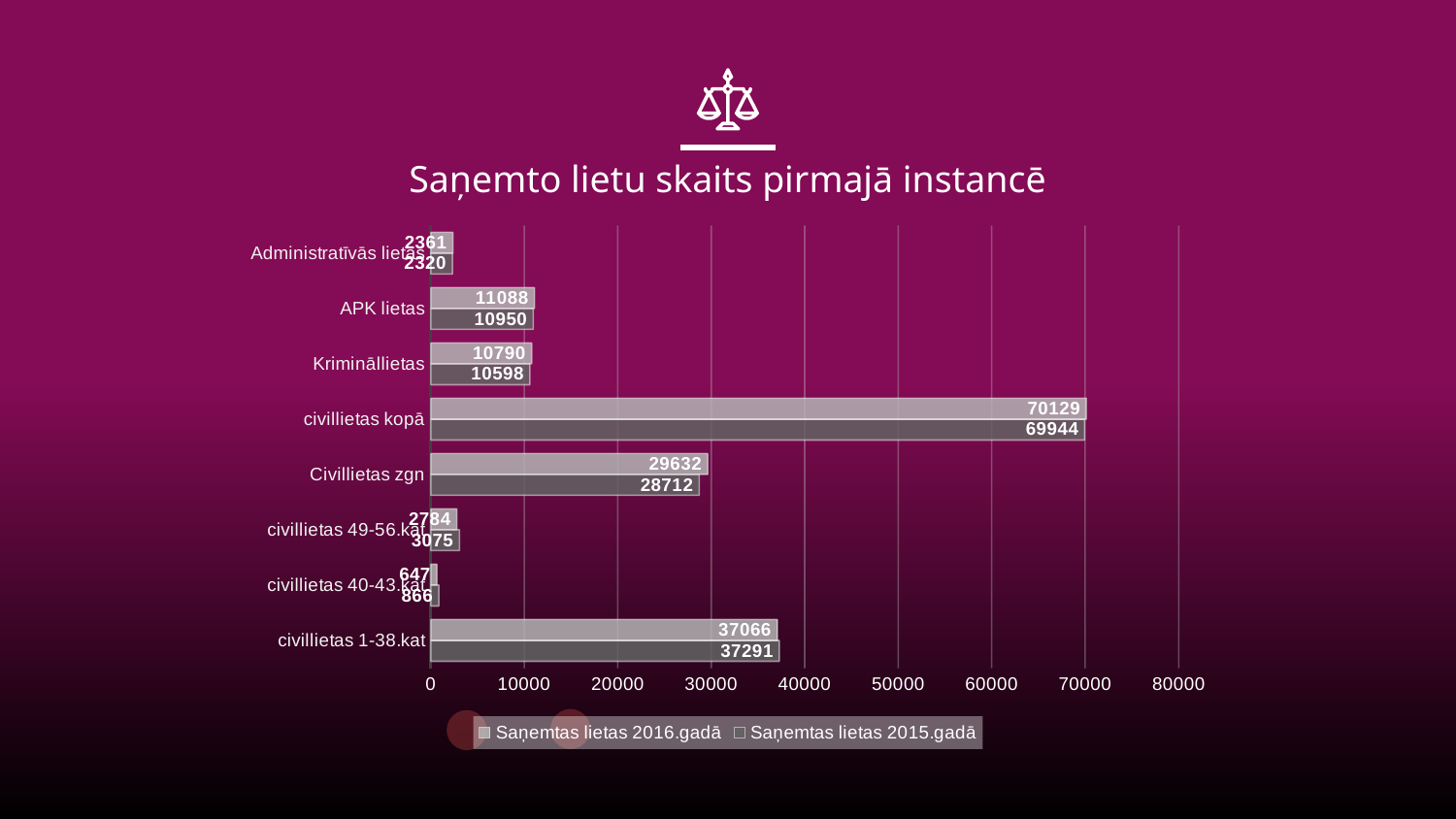
What is the value for civillietas kopā in the series Saņemtas lietas 2016.gadā? 69944 What is the title of the chart? Saņemto lietu skaits pirmajā instancē How many categories are shown on the chart? 8 What is the value for APK lietas in the series Saņemtas lietas 2015.gadā? 11088 What type of chart is shown on the slide? bar chart What is the difference between the 2015 and 2016 values for civillietas kopā? 185 For civillietas 1-38.kat, which series has the larger value, Saņemtas lietas 2016.gadā or Saņemtas lietas 2015.gadā? Saņemtas lietas 2016.gadā Which category has the highest values on the chart? civillietas kopā Which category has the lowest values on the chart? civillietas 40-43.kat Is the value for Civillietas zgn in the series Saņemtas lietas 2015.gadā greater or less than 30000? less How many series does the legend list? 2 What is the difference between the 2015 and 2016 values for Civillietas zgn? 920